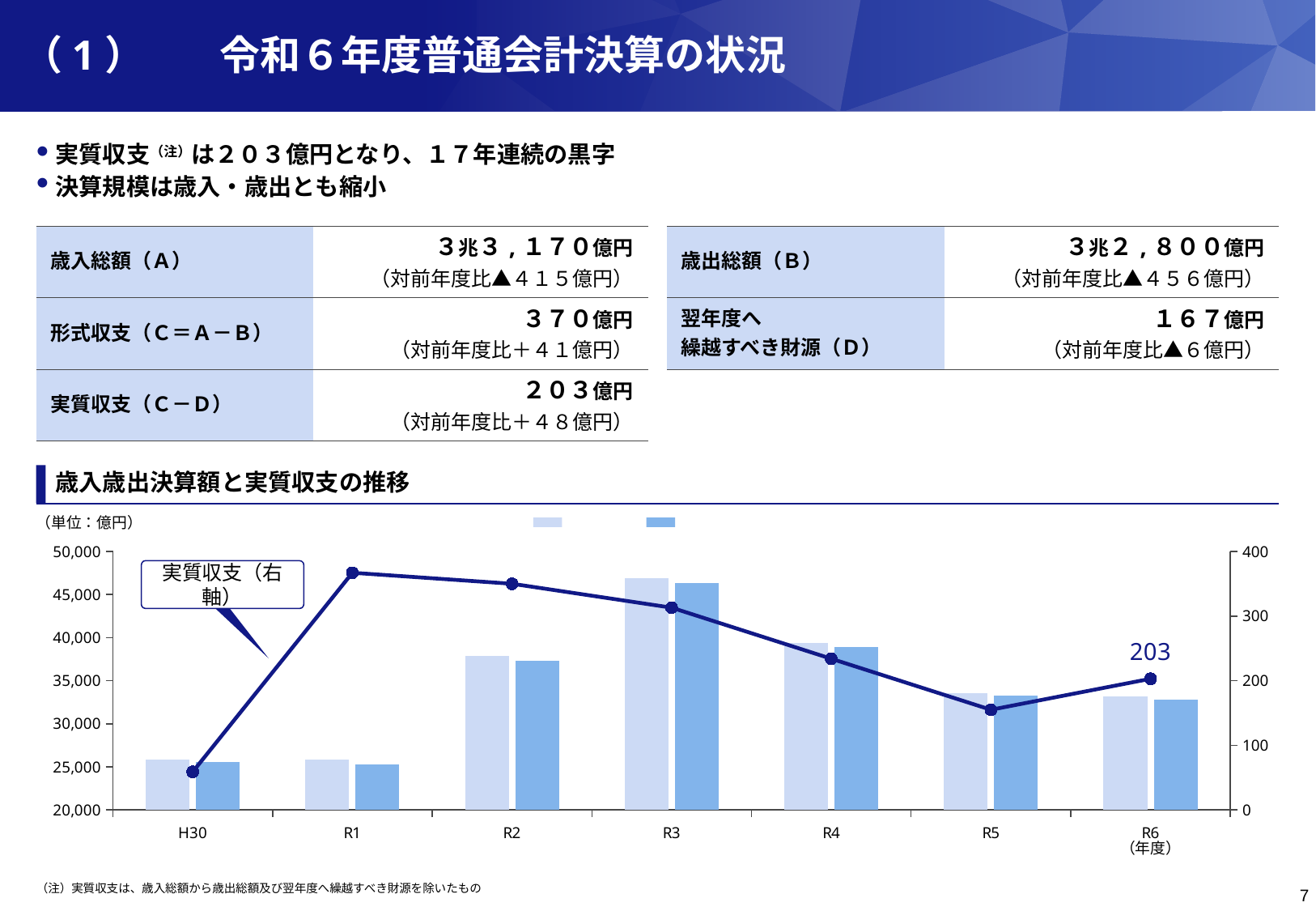
In which fiscal year is the 実質収支 line at its highest? R1 Is the 実質収支 value for H30 greater or less than 100 on the right axis? less From R1 to R5, does the 実質収支 line rise or fall? fall Is the 実質収支 value for R1 greater or less than 300 on the right axis? greater What unit is stated for the chart 歳入歳出決算額と実質収支の推移? 億円 Is the light blue bar for R3 greater or less than 45,000 on the left axis? greater What kind of chart is 歳入歳出決算額と実質収支の推移? A combination bar and line chart What is the value of the 実質収支 line at R6 in the chart 歳入歳出決算額と実質収支の推移? 203 Which is larger on the 実質収支 line, the value for R2 or the value for R4? R2 How many fiscal years are shown on the x axis of the chart? 7 In which fiscal year is the 実質収支 line at its lowest? H30